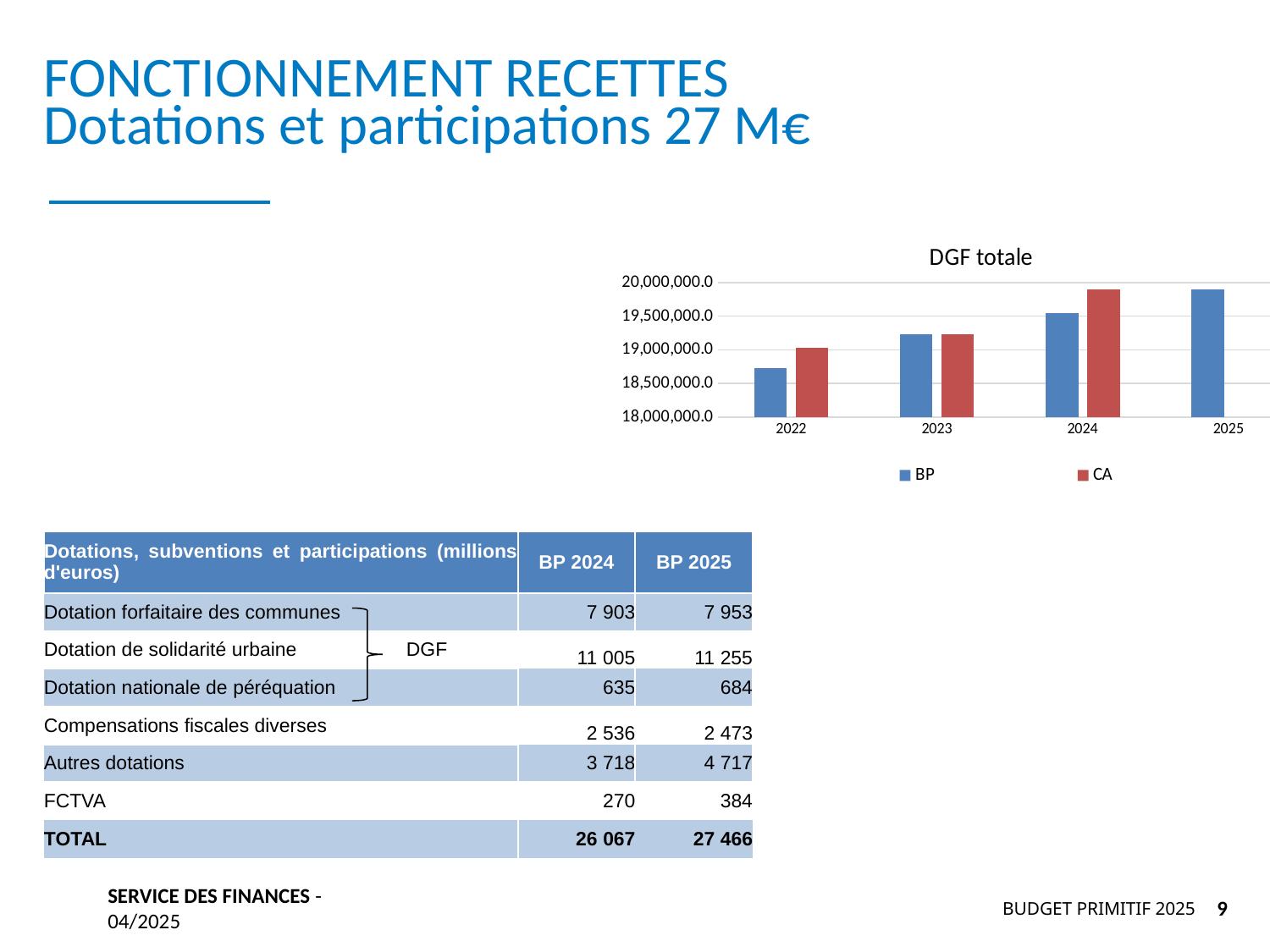
In the "DGF totale" chart, is the BP value for 2023 greater or less than 19,000,000.0? greater How many series does the legend of the "DGF totale" chart list? 2 In the "DGF totale" chart, is the BP value for 2022 greater or less than 19,000,000.0? less What kind of chart is the "DGF totale" chart? bar chart How many years are shown on the x axis of the "DGF totale" chart? 4 In the "DGF totale" chart, which year has the lowest BP value? 2022 In the "DGF totale" chart, which year has no CA bar? 2025 In the "DGF totale" chart, which is larger for 2024, BP or CA? CA In the "DGF totale" chart, which year has the highest BP value? 2025 In the "DGF totale" chart, do the BP values rise or fall from 2022 to 2025? rise In the "DGF totale" chart, is the CA value for 2024 greater or less than 19,500,000.0? greater In the "DGF totale" chart, which is larger for 2022, BP or CA? CA